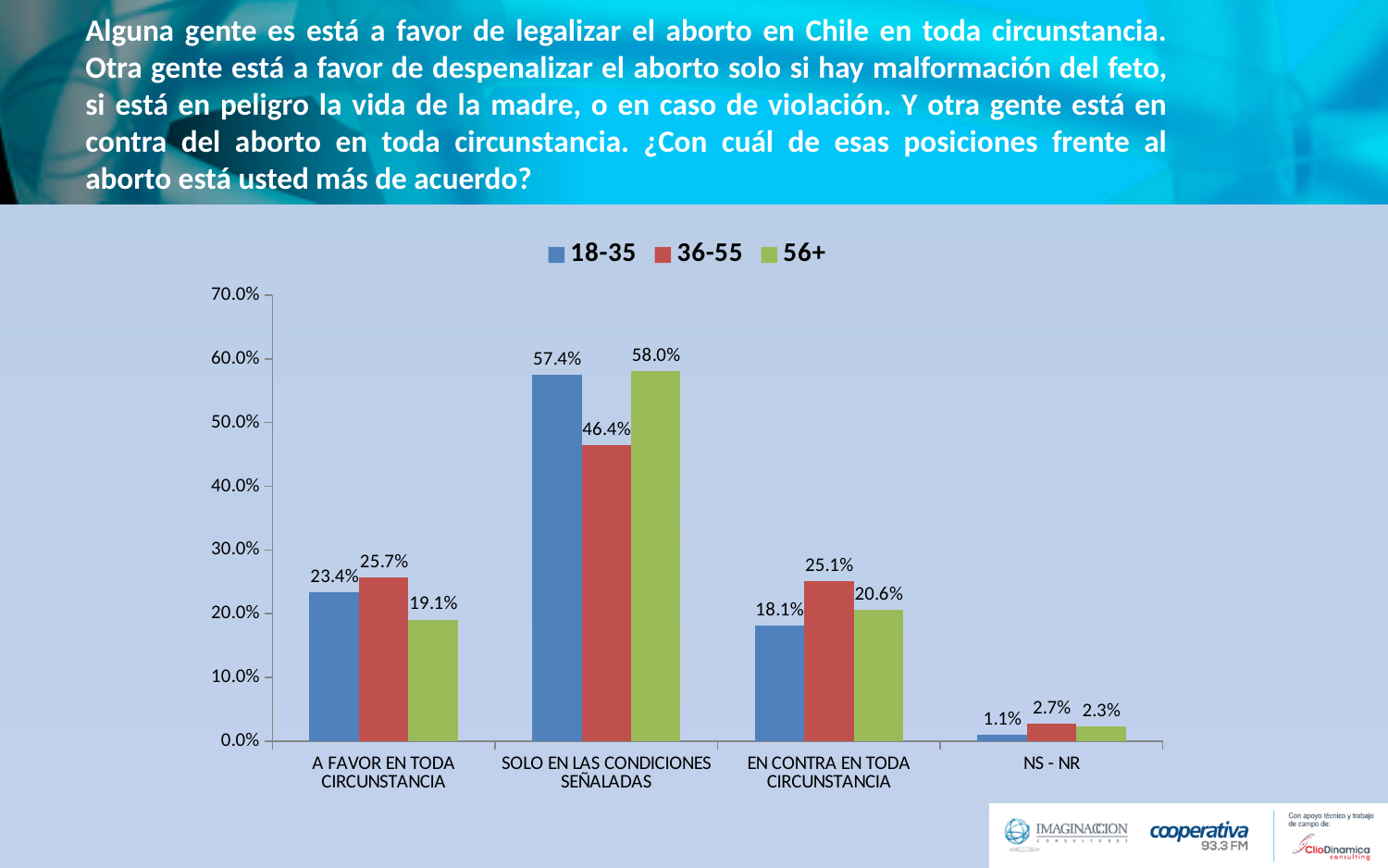
How many categories are shown on the x axis? 4 What is the value for the 56+ group in the 'A FAVOR EN TODA CIRCUNSTANCIA' category? 19.1% What percentage of the 18-35 group chose 'SOLO EN LAS CONDICIONES SEÑALADAS'? 57.4% Which age group is represented by the green bars? 56+ What is the difference between the 56+ and 36-55 values in the 'SOLO EN LAS CONDICIONES SEÑALADAS' category? 11.6% How many series does the legend list? 3 Which category has the highest value for the 56+ group? SOLO EN LAS CONDICIONES SEÑALADAS What kind of chart is shown on the slide? Bar chart Is the value for the 36-55 group in 'SOLO EN LAS CONDICIONES SEÑALADAS' greater or less than 50.0%? less Which category has the lowest value for the 18-35 group? NS - NR In the 'A FAVOR EN TODA CIRCUNSTANCIA' category, which group has the larger value, 18-35 or 36-55? 36-55 What is the value for the 36-55 group in the 'EN CONTRA EN TODA CIRCUNSTANCIA' category? 25.1%